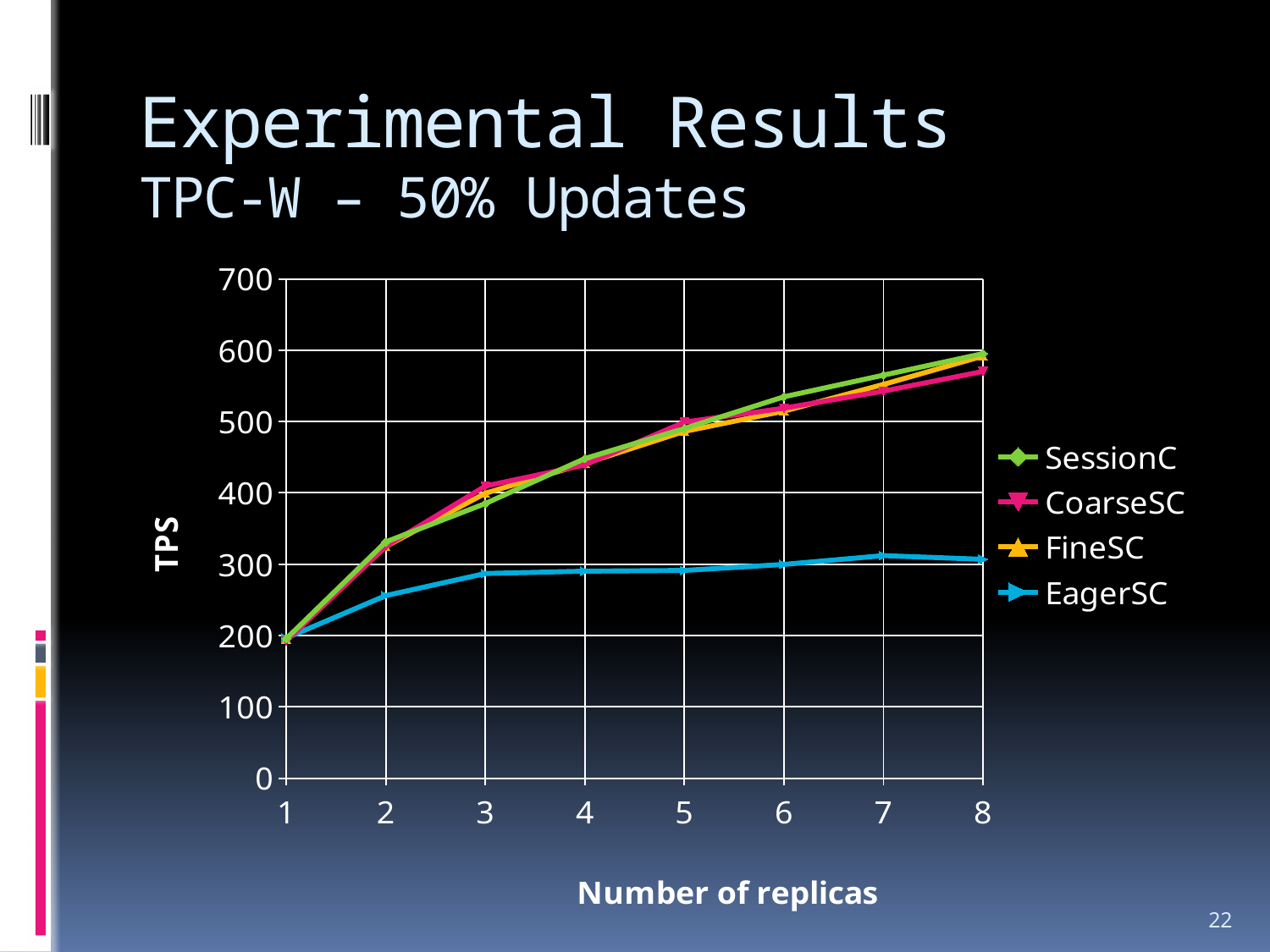
What kind of chart is shown on the slide? line chart How many points along the x axis (number of replicas) are plotted for each series? 8 Does the TPS for SessionC rise or fall as the number of replicas increases from 1 to 8? rise Is the TPS for SessionC at 8 replicas greater or less than 500? greater At 8 replicas, which is larger: the TPS for SessionC or for EagerSC? SessionC Is the TPS for EagerSC at 8 replicas greater or less than 400? less What is the label of the x axis? Number of replicas What is the label of the y axis? TPS Is the TPS for EagerSC at 2 replicas greater or less than 300? less How many series does the legend list? 4 Which series has the lowest TPS at 8 replicas? EagerSC